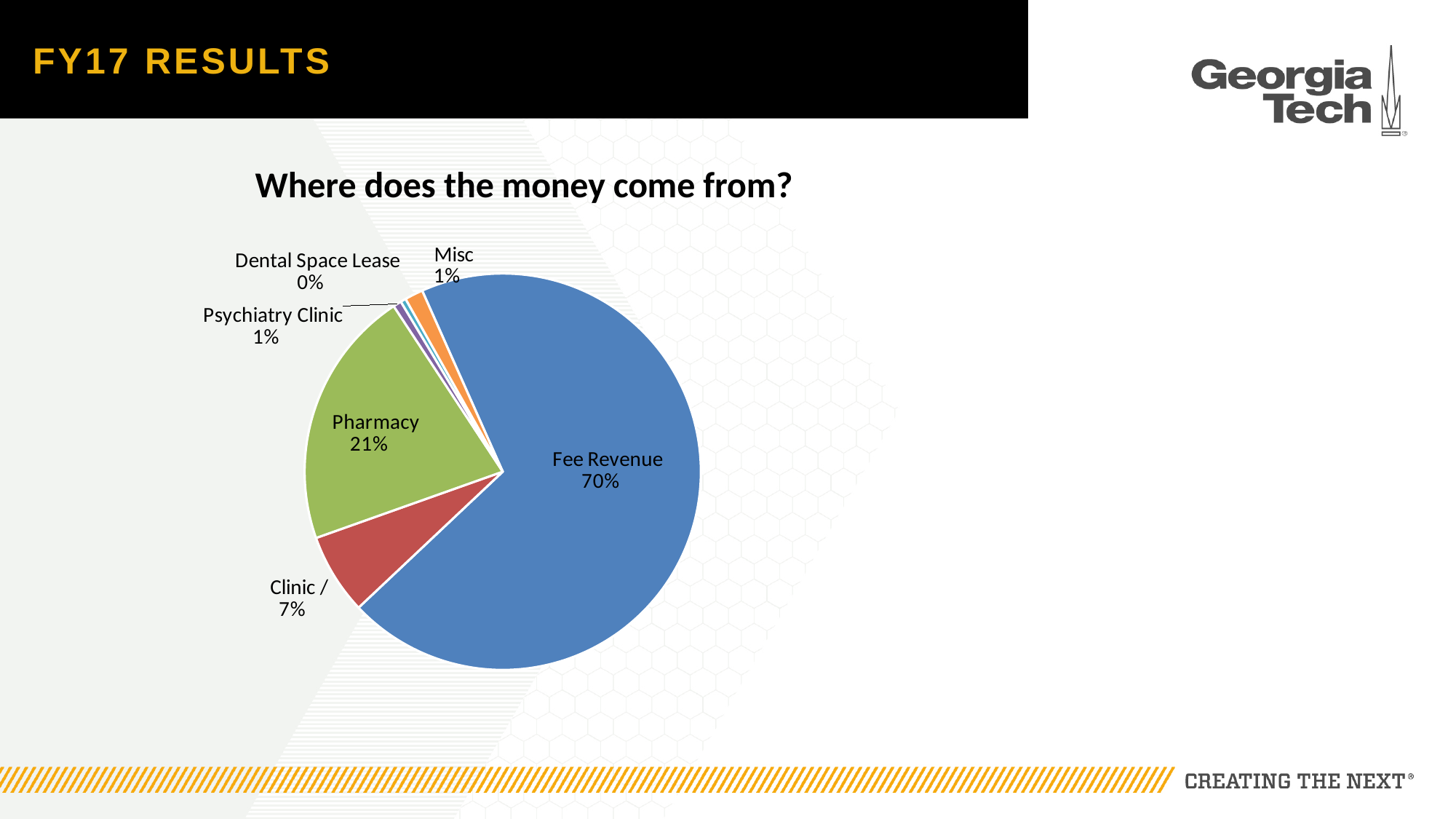
What percentage is shown for Clinic /? 7% Which category has the smallest share of the pie? Dental Space Lease What is the title of the chart? Where does the money come from? What percentage is shown for Psychiatry Clinic? 1% What percentage is shown for Pharmacy? 21% Which is larger, the share for Pharmacy or the share for Clinic /? Pharmacy What share of the pie does Fee Revenue account for? 70% What percentage is shown for Dental Space Lease? 0% What is the difference in percentage points between Fee Revenue and Pharmacy? 49 How many categories are shown in the pie chart? 6 What kind of chart is shown on the slide? Pie chart Which category has the largest share of the pie? Fee Revenue